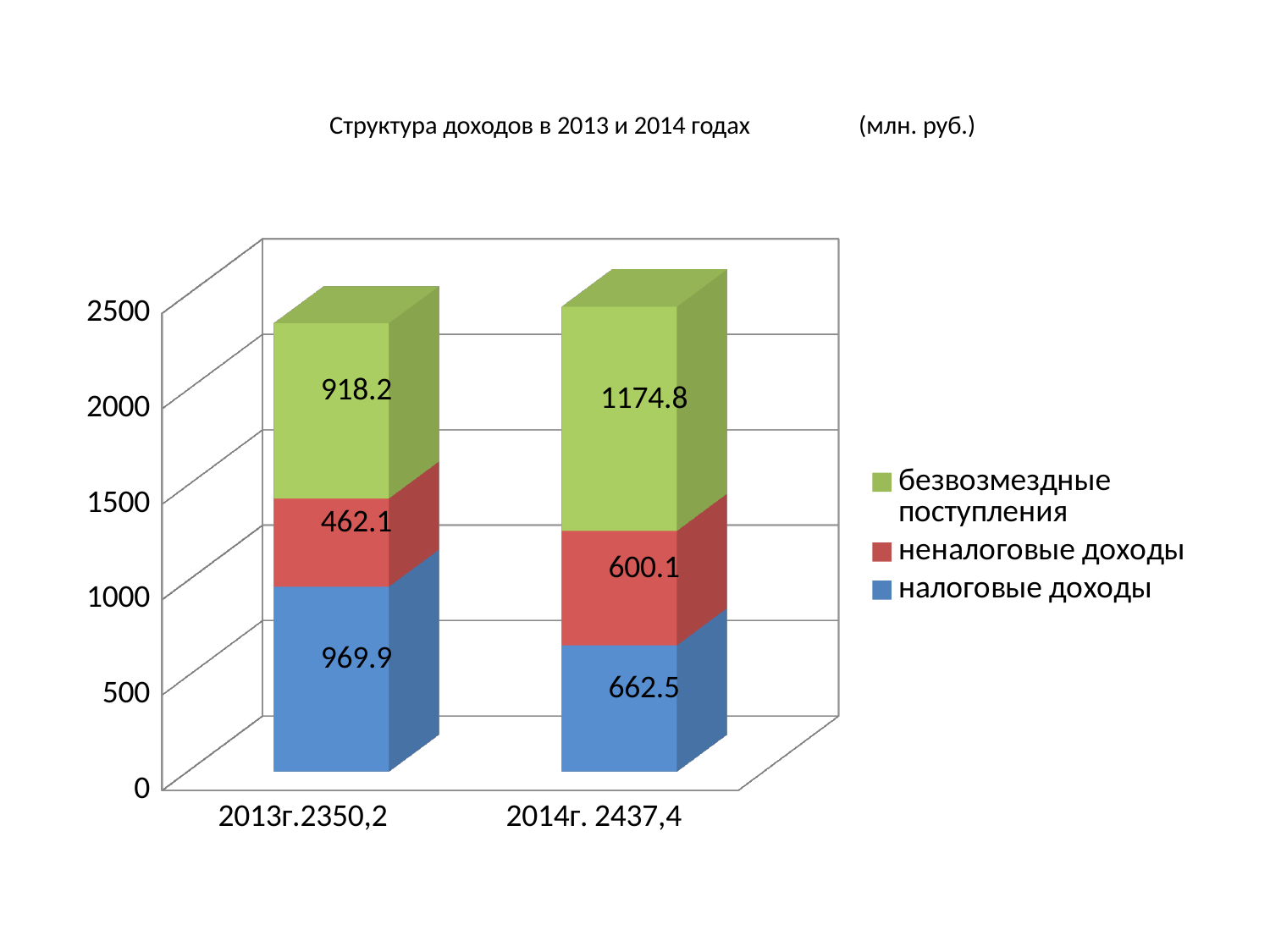
What is the value of налоговые доходы for 2013? 969.9 What is the total of the stacked bar for 2013? 2350.2 How many series does the legend list? 3 Which year has the higher value for налоговые доходы, 2013 or 2014? 2013 What is the total of the stacked bar for 2014? 2437.4 What is the value of неналоговые доходы for 2014? 600.1 What is the difference between налоговые доходы in 2013 and in 2014? 307.4 Which series is shown in green in the legend? безвозмездные поступления What is the difference between безвозмездные поступления in 2014 and in 2013? 256.6 What is the value of безвозмездные поступления for 2014? 1174.8 What kind of chart is shown on the slide? Stacked bar chart What is the value of неналоговые доходы for 2013? 462.1